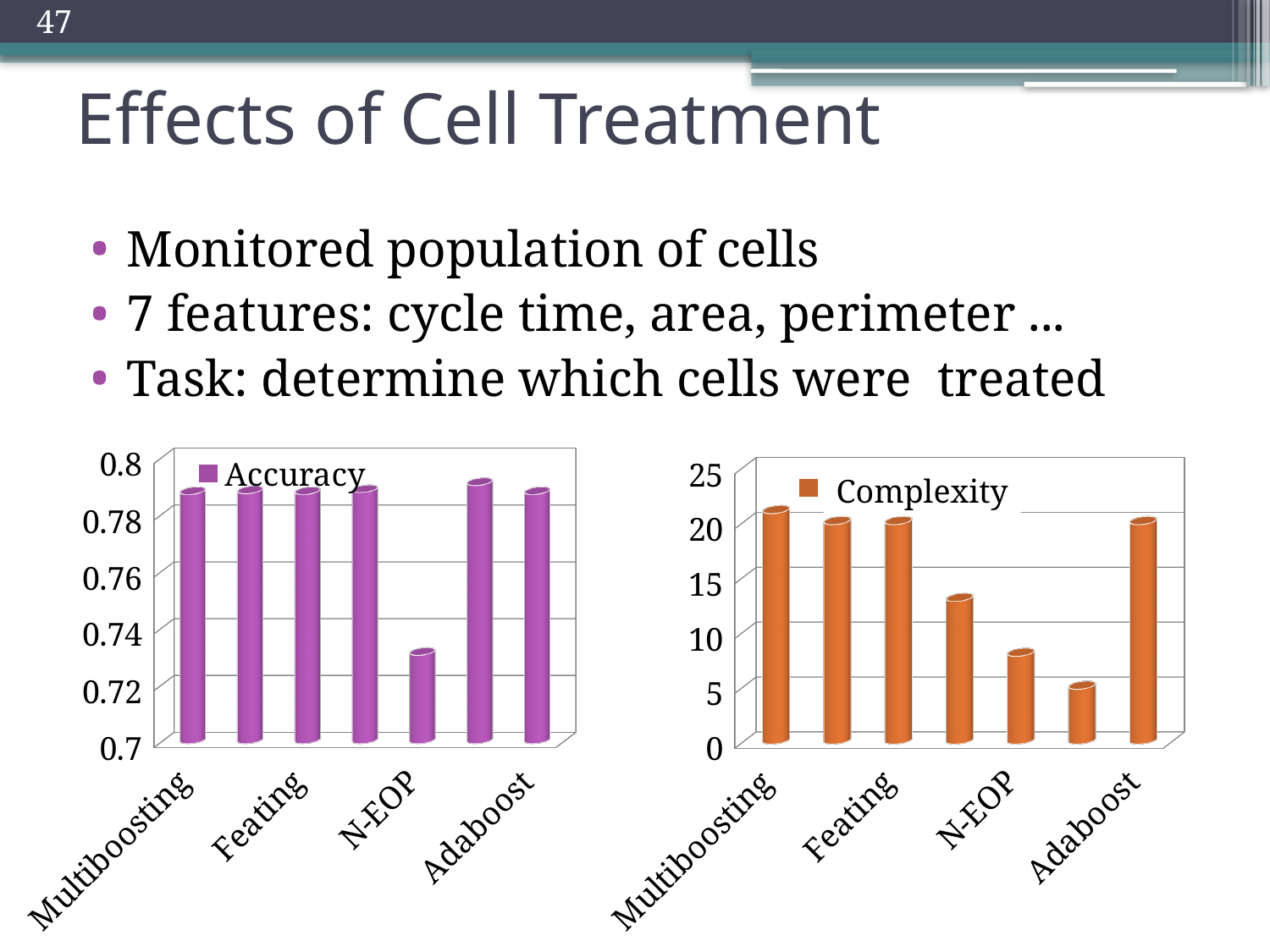
In the Accuracy chart, is the value for Multiboosting greater or less than 0.78? greater What kind of chart is the Accuracy chart on the left? bar chart In the Complexity chart, is the value for N-EOP greater or less than 10? less How many bars are plotted in the Complexity chart on the right? 7 In the Accuracy chart, which labelled method has the lowest accuracy? N-EOP In the Complexity chart, which has the higher complexity, Multiboosting or N-EOP? Multiboosting In the Accuracy chart, which has the higher accuracy, N-EOP or Adaboost? Adaboost What is the legend entry of the chart on the right? Complexity In the Complexity chart, is the value for Adaboost greater or less than 15? greater How many series does the legend of the Accuracy chart list? 1 What colour are the bars in the Accuracy chart? purple